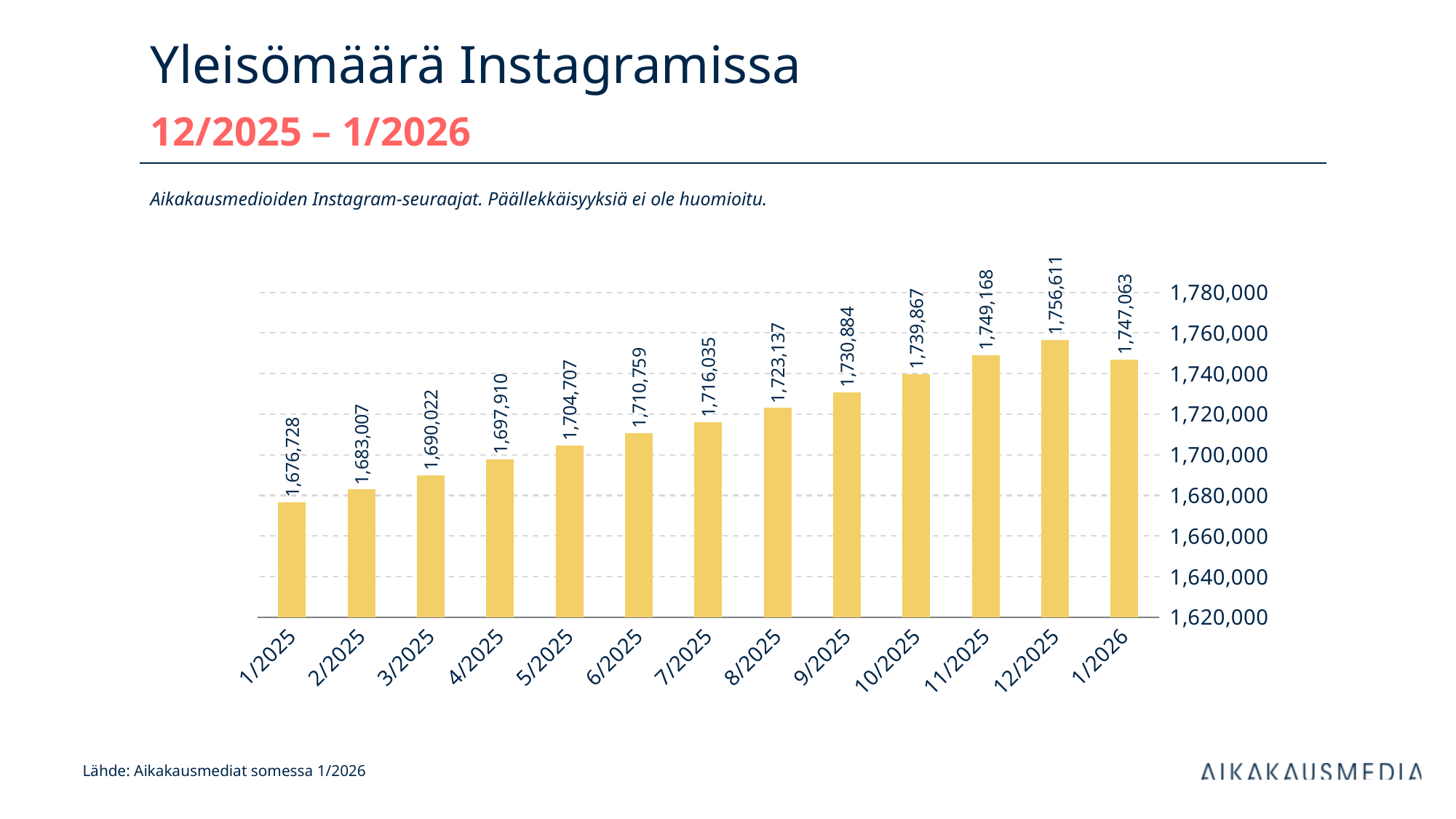
What is the value for 12/2025? 1,756,611 What kind of chart is shown? bar chart What is the value for 1/2026? 1,747,063 Which month has the highest value? 12/2025 What is the difference between the values for 12/2025 and 1/2026? 9,548 What is the value for 6/2025? 1,710,759 Do the values rise or fall from 1/2025 to 12/2025? rise Which month has the lowest value? 1/2025 How many months are shown on the x axis? 13 Which is larger, the value for 11/2025 or the value for 1/2026? 11/2025 What is the value for 1/2025? 1,676,728 What is the difference between the values for 1/2026 and 1/2025? 70,335